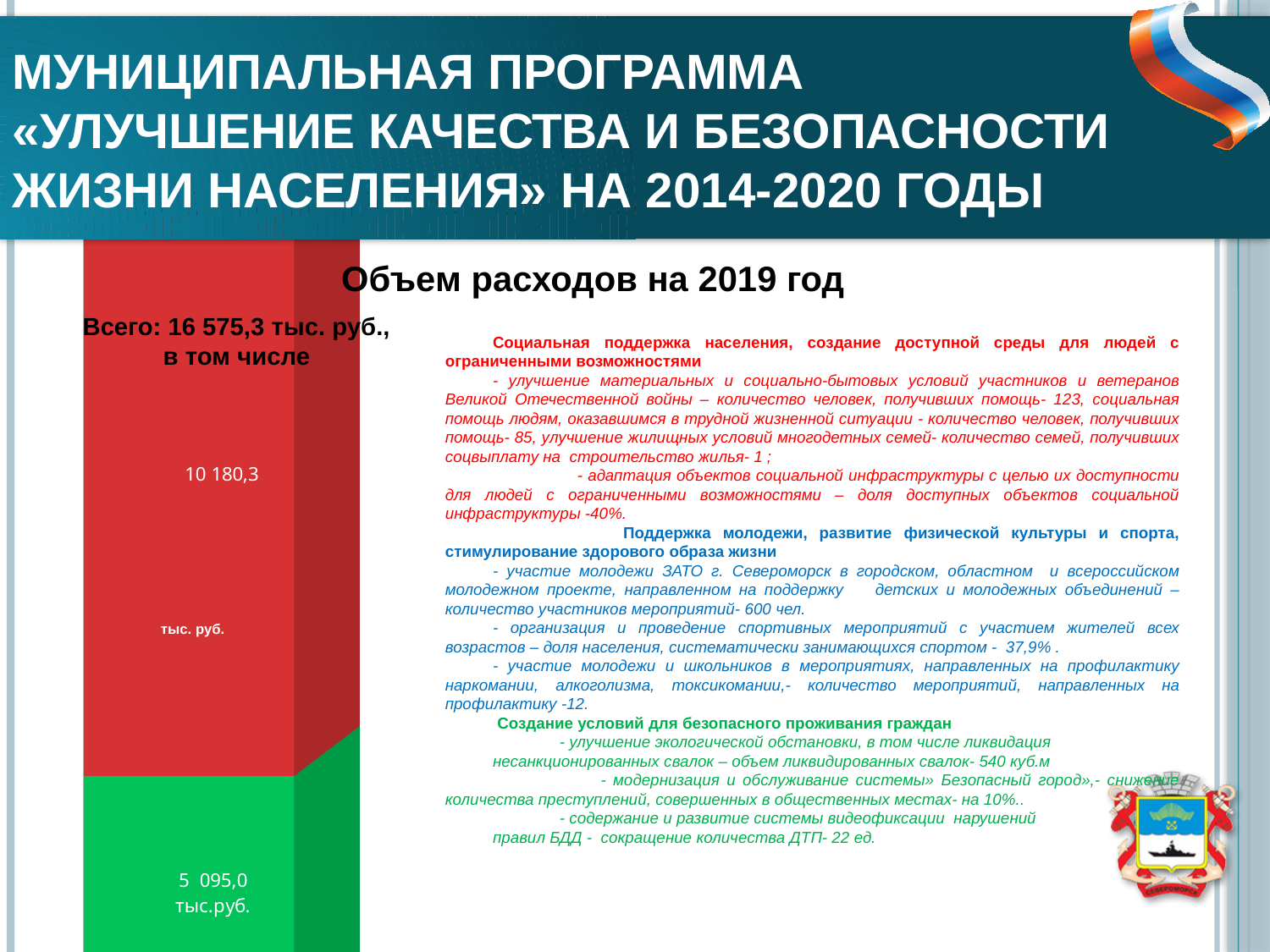
What value is printed on the red segment of the bar? 10 180,3 What is the difference between the red segment value (10 180,3) and the green segment value (5 095,0)? 5 085,3 Which segment of the bar is larger, the red one or the green one? the red one In what units are the values on the chart expressed? тыс. руб. What value is printed on the green segment of the bar? 5 095,0 тыс.руб. What kind of chart is shown on the left of the slide? bar chart Is the value of the green segment greater or less than 10 000? less What total amount is stated above the chart (Всего)? 16 575,3 тыс. руб. Is the value of the red segment greater or less than 10 000? greater How many labelled segments are visible in the bar? 2 What is the title of the chart section on the slide? Объем расходов на 2019 год